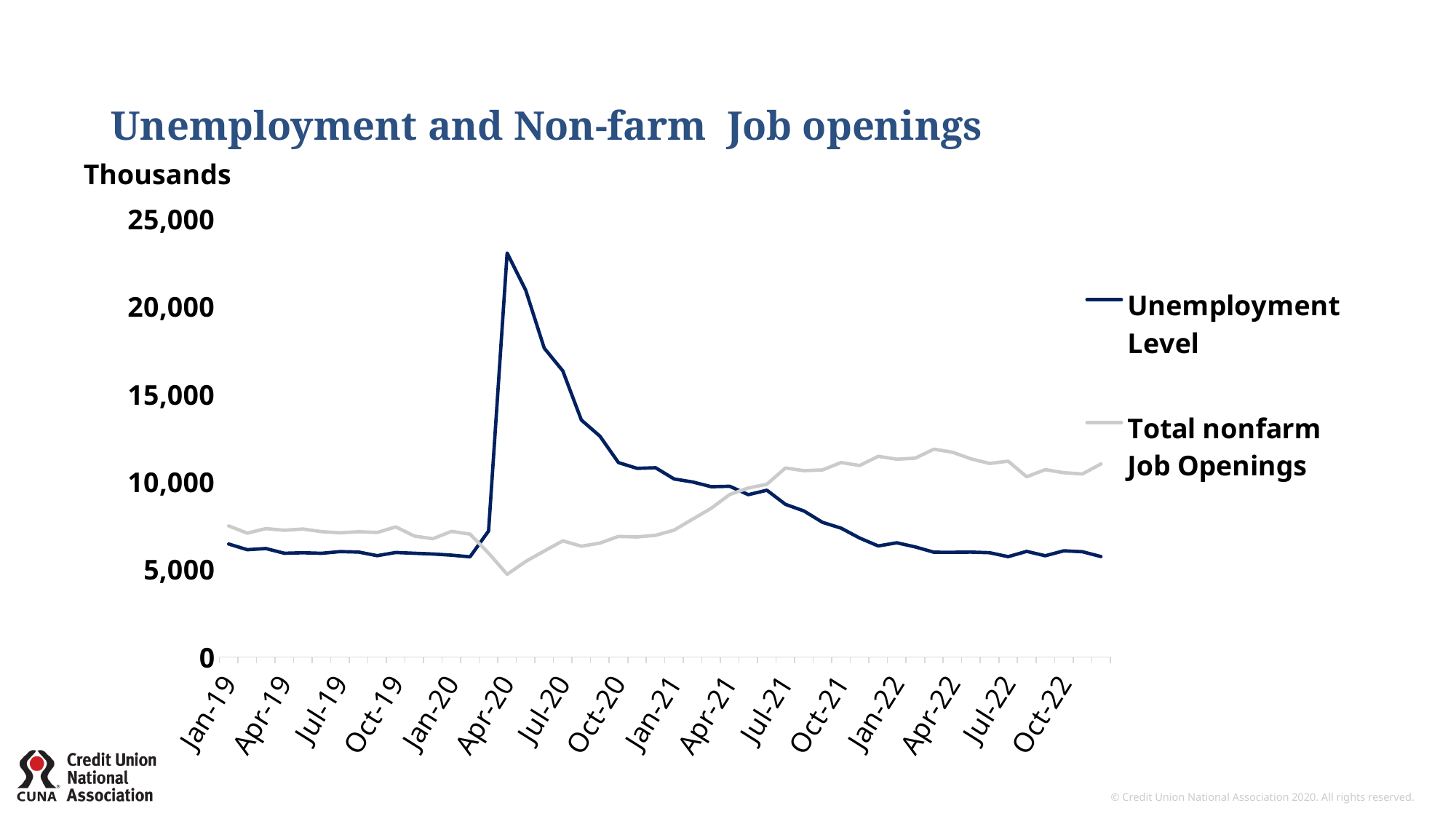
Is the Unemployment Level at Apr-20 greater or less than 20,000? greater At Jan-22, which series has the higher value, Unemployment Level or Total nonfarm Job Openings? Total nonfarm Job Openings Is the Unemployment Level at Jan-19 greater or less than 10,000? less How many series does the legend list? 2 What is the title of the chart? Unemployment and Non-farm Job openings In which month does the Unemployment Level reach its highest point? Apr-20 At Jul-20, which series has the higher value, Unemployment Level or Total nonfarm Job Openings? Unemployment Level In which month does Total nonfarm Job Openings reach its lowest point? Apr-20 What kind of chart is shown on the slide? Line chart Does the Unemployment Level rise or fall from Jul-20 to Oct-22? fall Is the value for Total nonfarm Job Openings at Apr-22 greater or less than 10,000? greater What unit label is shown above the vertical axis? Thousands